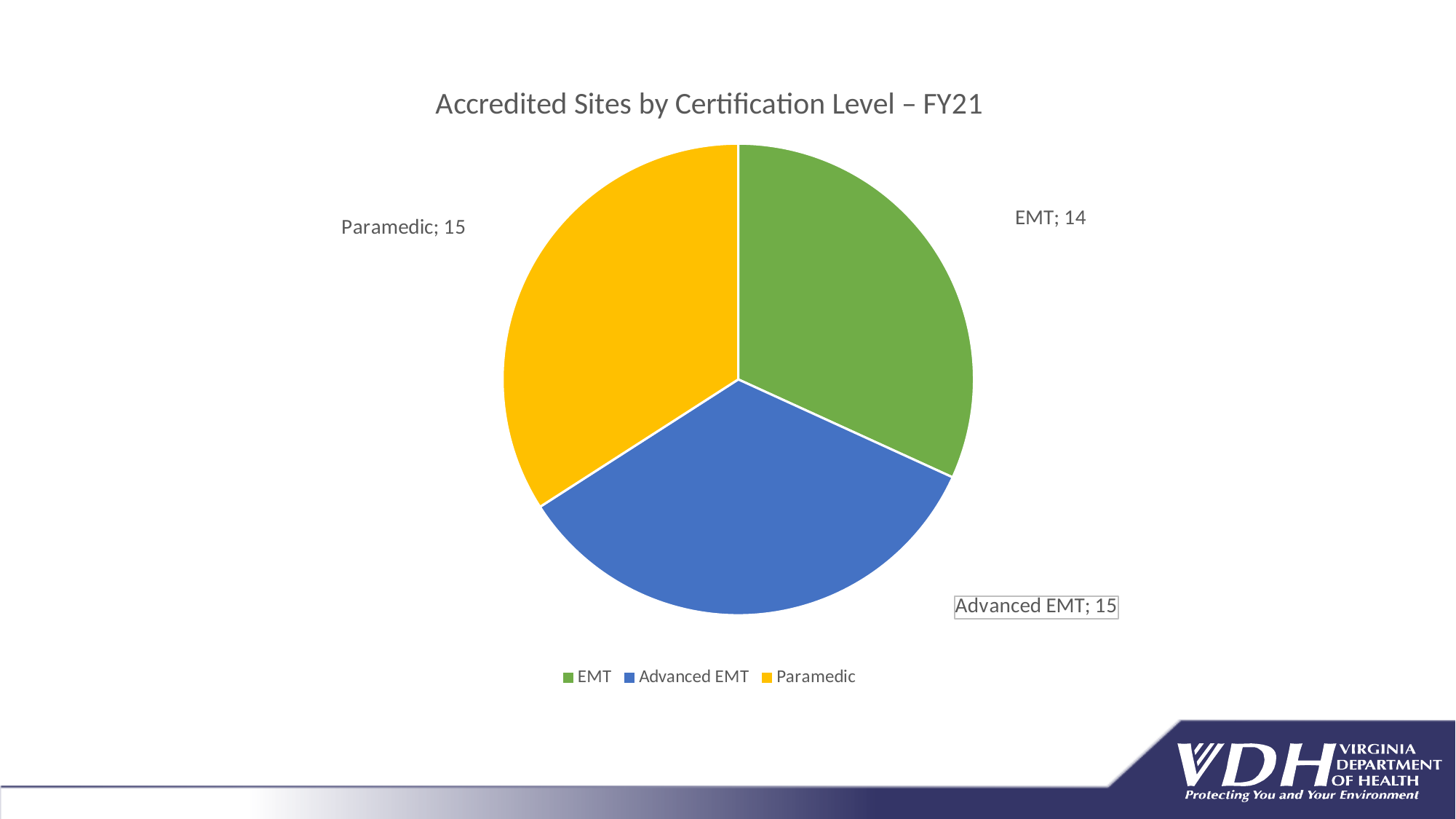
How many accredited sites are at the Paramedic certification level? 15 How many accredited sites are at the EMT certification level? 14 How many accredited sites are at the Advanced EMT certification level? 15 What type of chart is shown on the slide? pie chart How many certification levels are shown in the pie chart? 3 What is the difference between the number of Paramedic sites and EMT sites? 1 What is the total number of accredited sites across all certification levels? 44 Which has more accredited sites, EMT or Paramedic? Paramedic How many entries does the legend list? 3 Which certification level has the fewest accredited sites? EMT Which colour represents Advanced EMT in the pie chart? blue What is the title of the chart? Accredited Sites by Certification Level – FY21